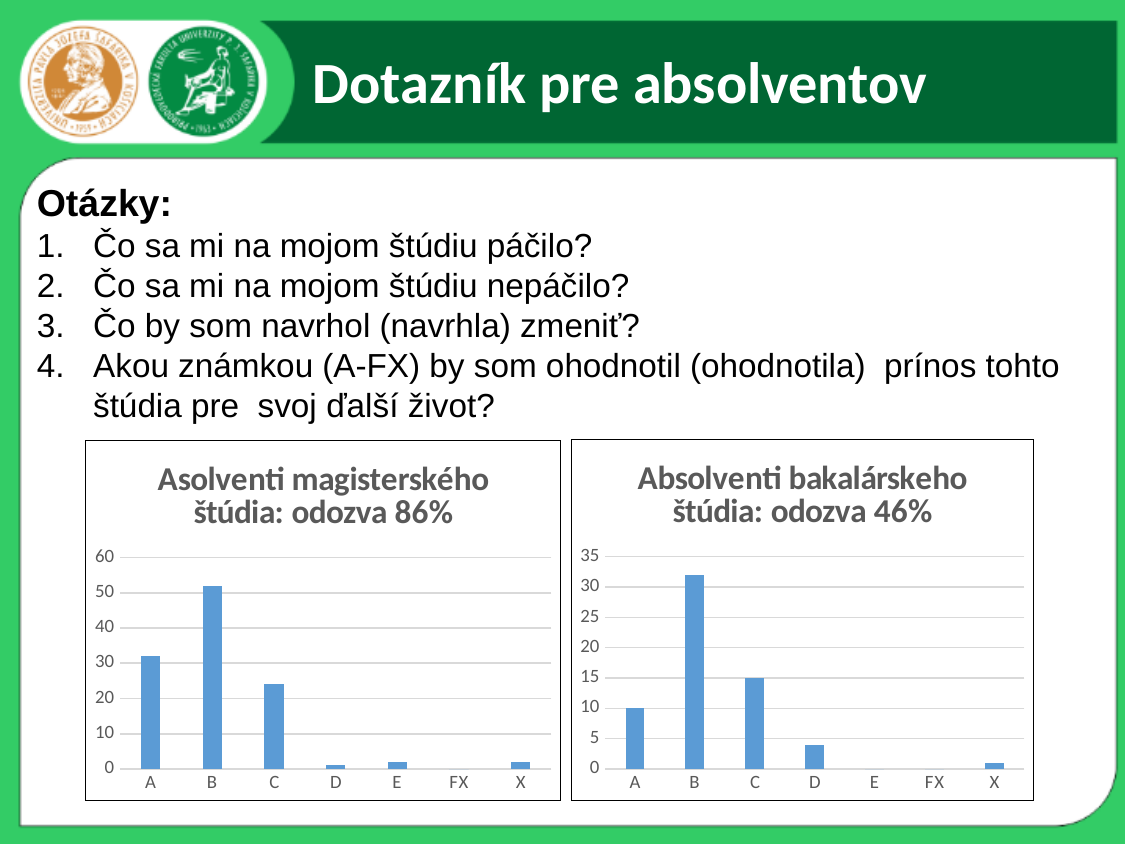
How many grade categories are shown on the x axis of the right chart (bakalárskeho štúdia)? 7 In the right chart (bakalárskeho štúdia), is the value for D greater or less than 5? less In the right chart (bakalárskeho štúdia), which is larger, the value for C or the value for A? C In the right chart (bakalárskeho štúdia), which grade category has the highest value? B In the left chart (magisterského štúdia), which grade category has the lowest value? FX What kind of chart is the left chart, 'Asolventi magisterského štúdia: odozva 86%'? bar chart In the left chart (magisterského štúdia), is the value for C greater or less than 30? less In the left chart (magisterského štúdia), which is larger, the value for A or the value for C? A What response rate is stated in the title of the left chart? 86% In the left chart (magisterského štúdia), is the value for B greater or less than 50? greater In the left chart (magisterského štúdia), which grade category has the highest value? B